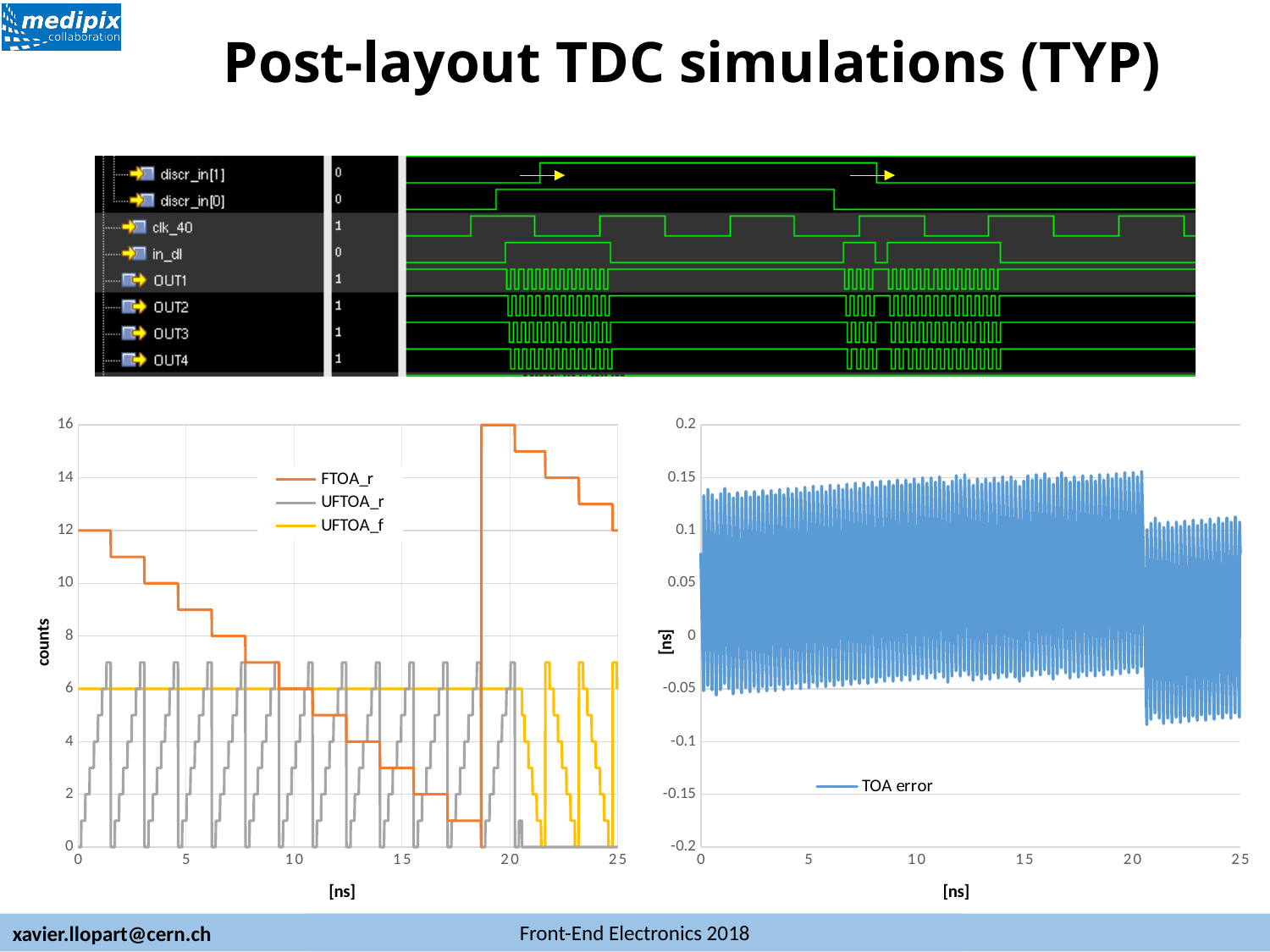
In the right chart, is the TOA error at any point greater or less than 0.2? less In the left chart, what is the highest value reached by the FTOA_r series? 16 In the left chart, what is the value of FTOA_r at 0 ns? 12 How many series does the legend of the right chart list? 1 In the right chart, is the peak TOA error after 20 ns larger or smaller than the peak TOA error before 20 ns? smaller What kind of chart is the left chart with the y-axis labelled 'counts'? line chart What is the y-axis label of the left chart? counts In the left chart, is the value of UFTOA_f at 10 ns greater or less than 8? less What is the name of the series plotted in the right chart? TOA error What kind of chart is the right chart showing TOA error? line chart In the left chart, does the FTOA_r series rise or fall between 0 ns and about 18 ns? fall How many series does the legend of the left chart (counts vs [ns]) list? 3